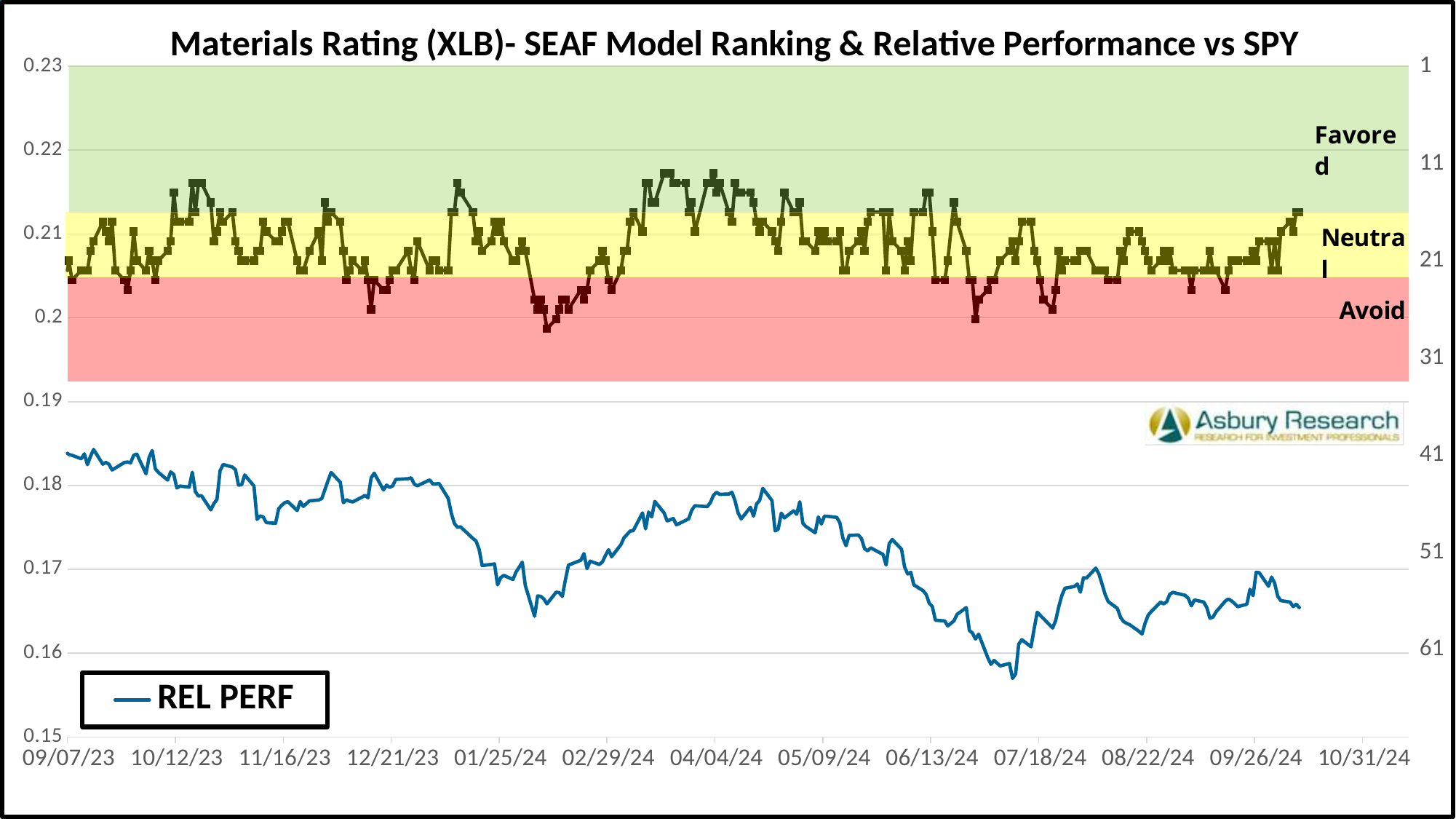
What is the title of the chart? Materials Rating (XLB)- SEAF Model Ranking & Relative Performance vs SPY Which series is listed in the chart's legend? REL PERF Is the REL PERF value at the right end of the line (around 10/2024) greater or less than 0.17? less Is the lowest point of the REL PERF line greater or less than 0.16? less Is the REL PERF value at 09/07/23 greater or less than 0.18? greater What is the highest value shown on the left vertical axis? 0.23 What is the lowest value shown on the right vertical axis? 61 What are the three rating zones labelled on the right side of the chart? Favored, Neutral, Avoid Does the REL PERF line overall rise or fall from 09/07/23 to its last point? fall How many date labels are shown along the x axis? 13 What kind of chart is shown on the slide? Line chart